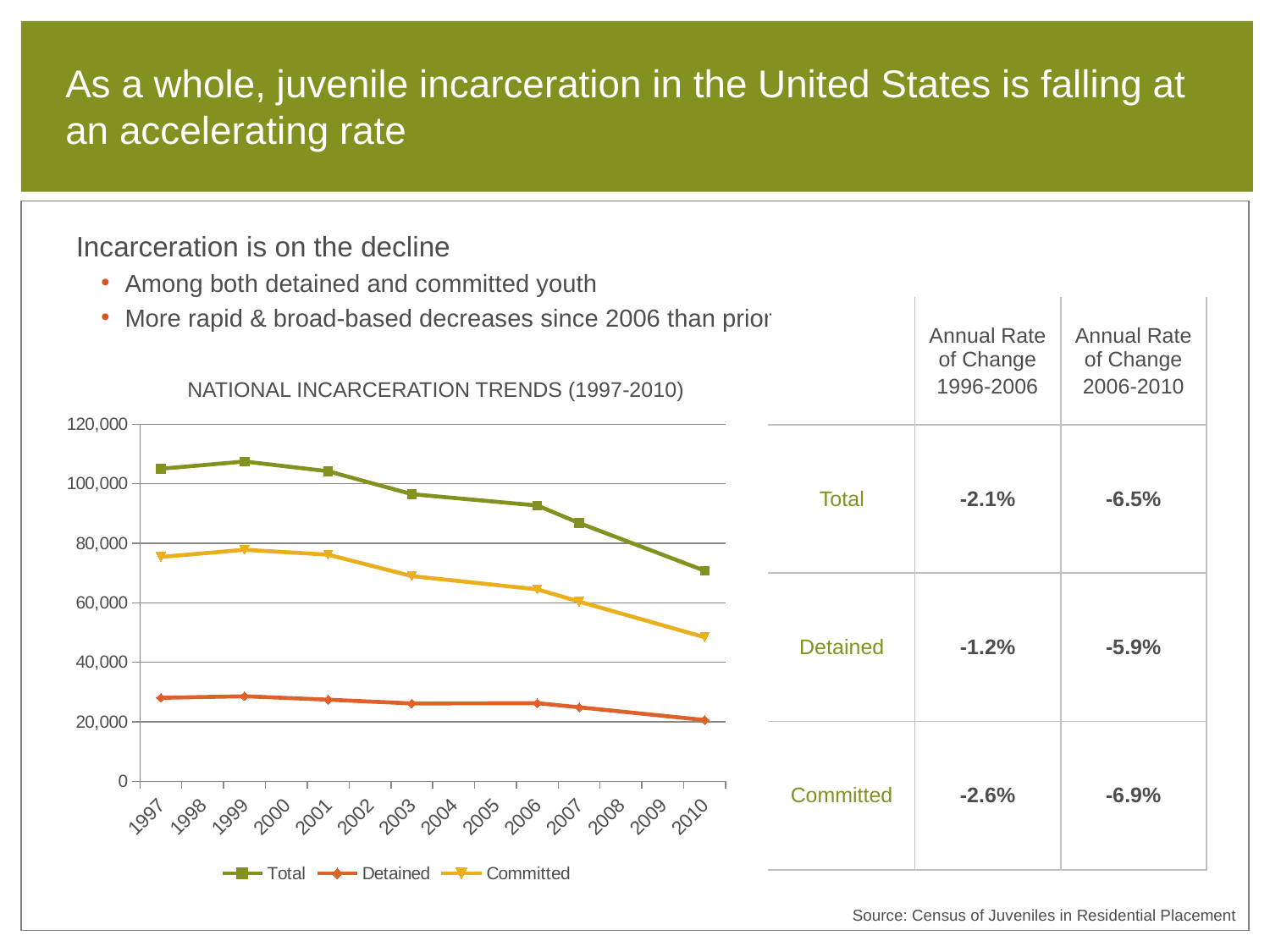
Is the value for Committed in 2010 greater or less than 60,000? less What kind of chart is shown on the slide? line chart Is the value for Total in 1997 greater or less than 100,000? greater Is the value for Total in 2010 greater or less than 80,000? less What is the title of the chart? NATIONAL INCARCERATION TRENDS (1997-2010) How many years are labelled on the x axis of the chart? 14 Do the values of the Total series rise or fall from 1999 to 2010? fall Which is larger, the Total value in 1999 or the Total value in 2010? 1999 Which series has the lowest values throughout the chart? Detained Which series has the highest values throughout the chart? Total How many series does the chart's legend list? 3